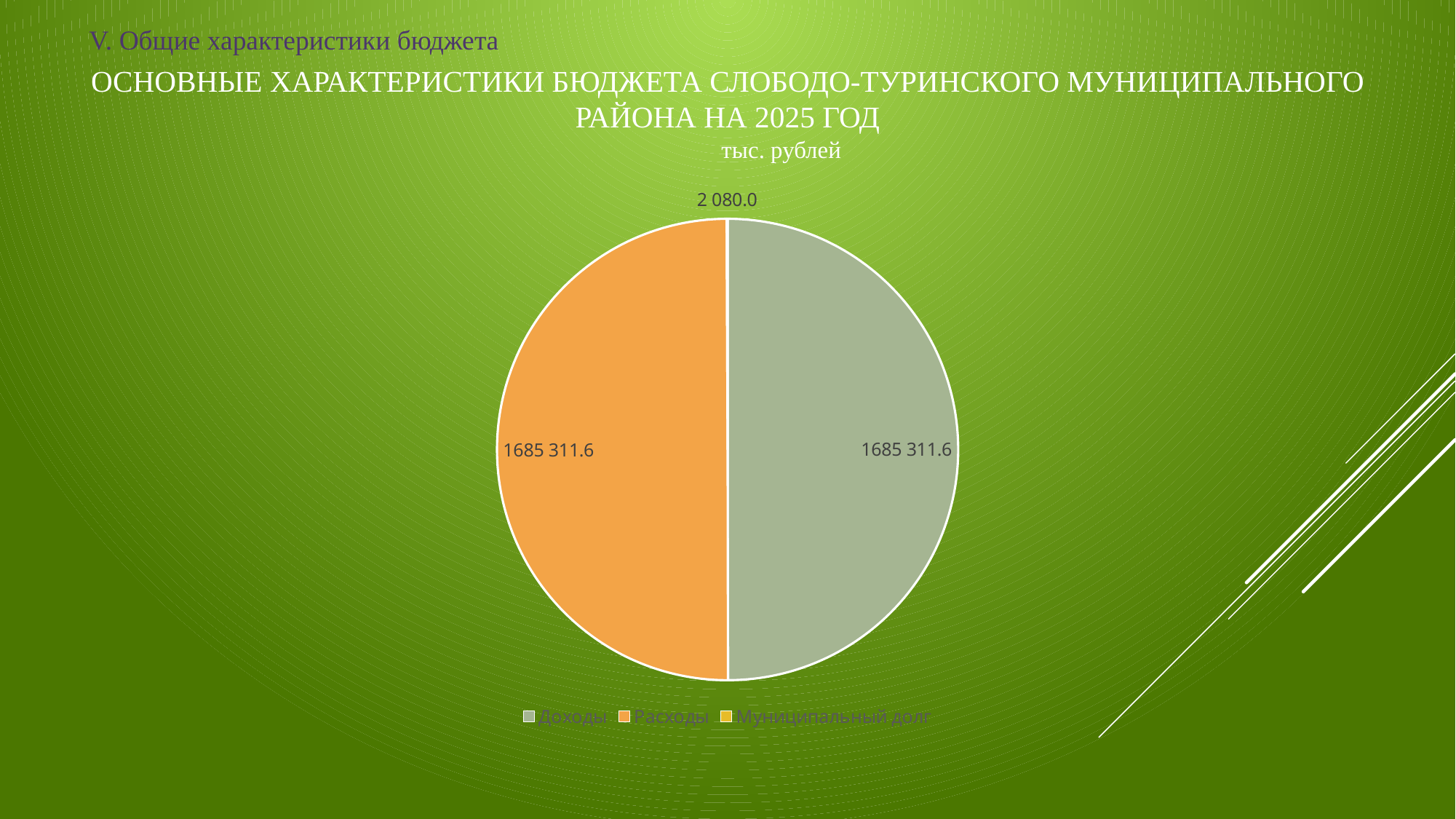
How many slices does the pie chart have? 3 Which category has the smallest slice of the pie? Муниципальный долг What is the value for Муниципальный долг? 2 080.0 In what units are the chart values given, according to the subtitle? тыс. рублей What is the difference between the values for Доходы and Расходы? 0 What is the total of all three values shown on the pie chart? 3 372 703.2 What is the value for Доходы? 1685 311.6 What colour is the Расходы slice? orange What type of chart is shown on the slide? pie chart How many entries does the legend list? 3 Is the value for Доходы larger than, smaller than, or equal to the value for Расходы? equal What is the value for Расходы? 1685 311.6